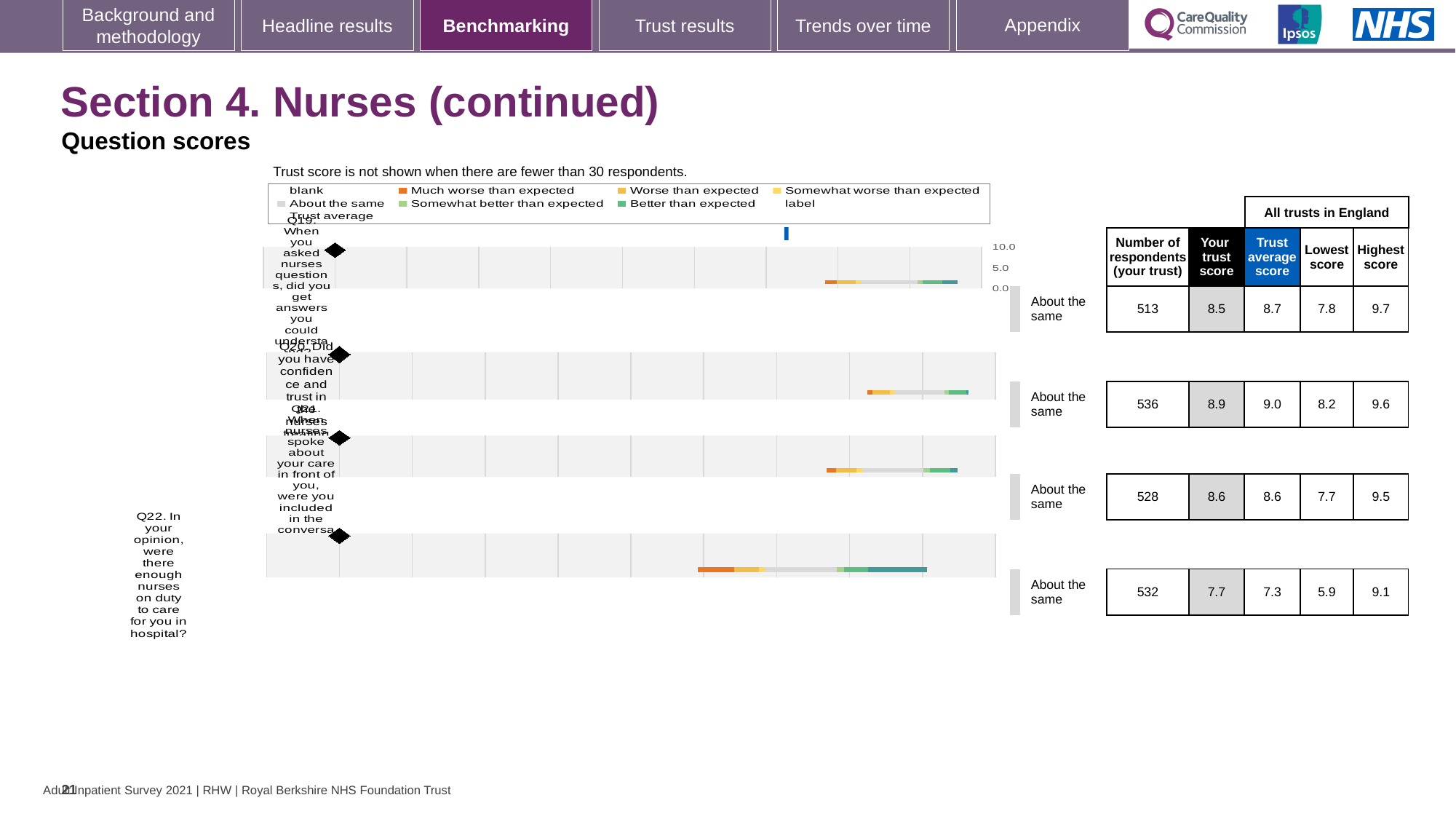
Which question has the lowest 'Your trust score'? Q22 What is the 'Your trust score' for Q22 (were there enough nurses on duty to care for you in hospital)? 7.7 What benchmark category is shown for Q21 (when nurses spoke about your care in front of you, were you included in the conversation)? About the same How many survey questions are plotted in the chart? 4 What is the subtitle shown above the chart on this slide? Question scores For Q19, which is larger: your trust score or the trust average score? Trust average score How many respondents from your trust answered Q20 (did you have confidence and trust in the nurses)? 536 What is the lowest score across all trusts in England for Q19? 7.8 What kind of chart is used to show the question scores? bar chart By how much does your trust score exceed the trust average score for Q22? 0.4 What is the difference between the highest score and the lowest score across all trusts in England for Q22? 3.2 Which question has the highest 'Your trust score'? Q20